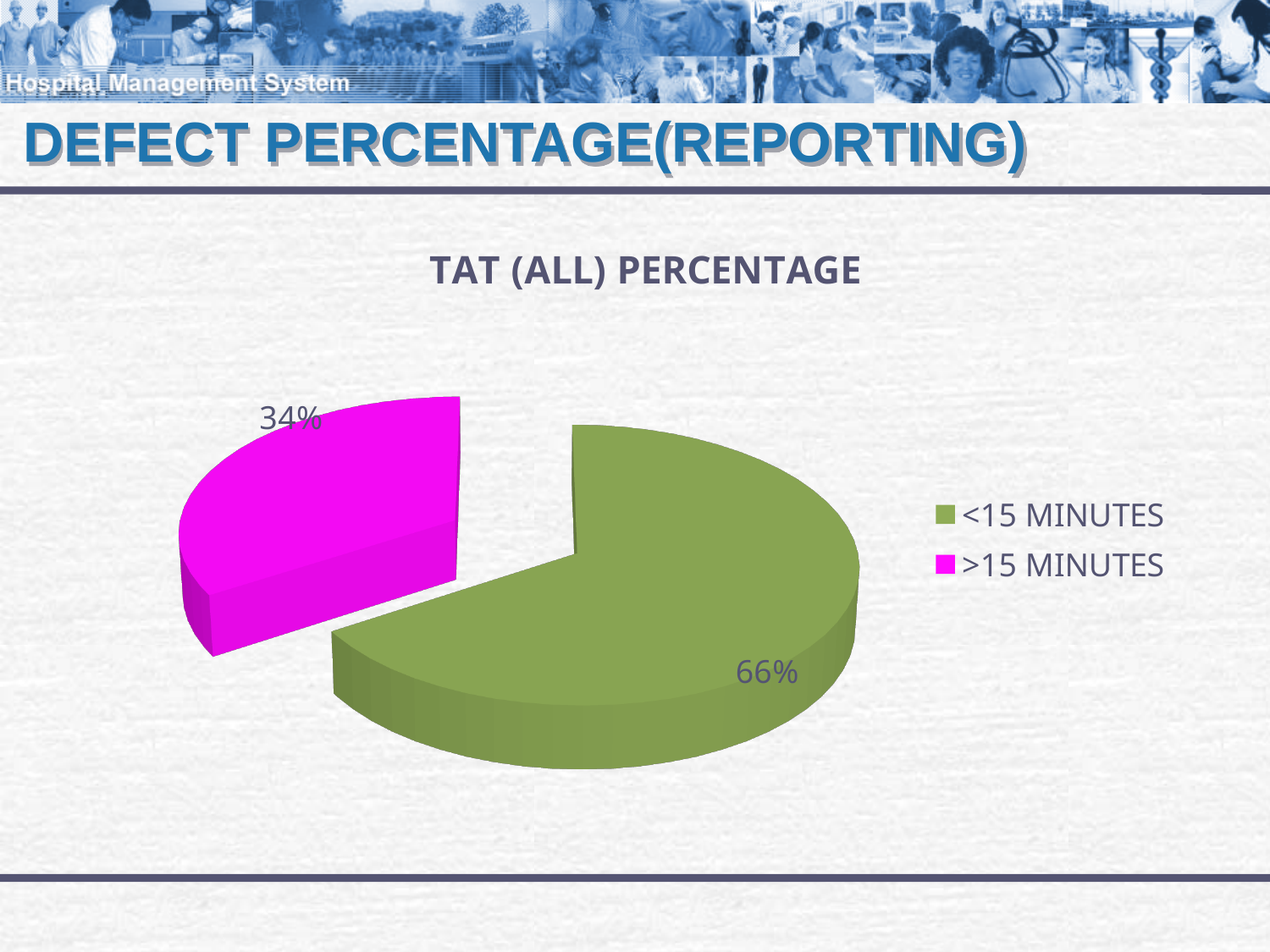
How many slices does the pie chart have? 2 What percentage is shown for the <15 MINUTES slice? 66% What share of the pie does the <15 MINUTES slice represent? 66% What colour is the >15 MINUTES slice? Magenta What percentage is shown for the >15 MINUTES slice? 34% Which is larger, the share for <15 MINUTES or the share for >15 MINUTES? <15 MINUTES What kind of chart is shown on the slide? Pie chart What is the title of the chart? TAT (ALL) PERCENTAGE How many entries does the legend list? 2 Which category has the largest share of the pie? <15 MINUTES Which category has the smallest share of the pie? >15 MINUTES What is the difference in percentage points between the <15 MINUTES and >15 MINUTES slices? 32